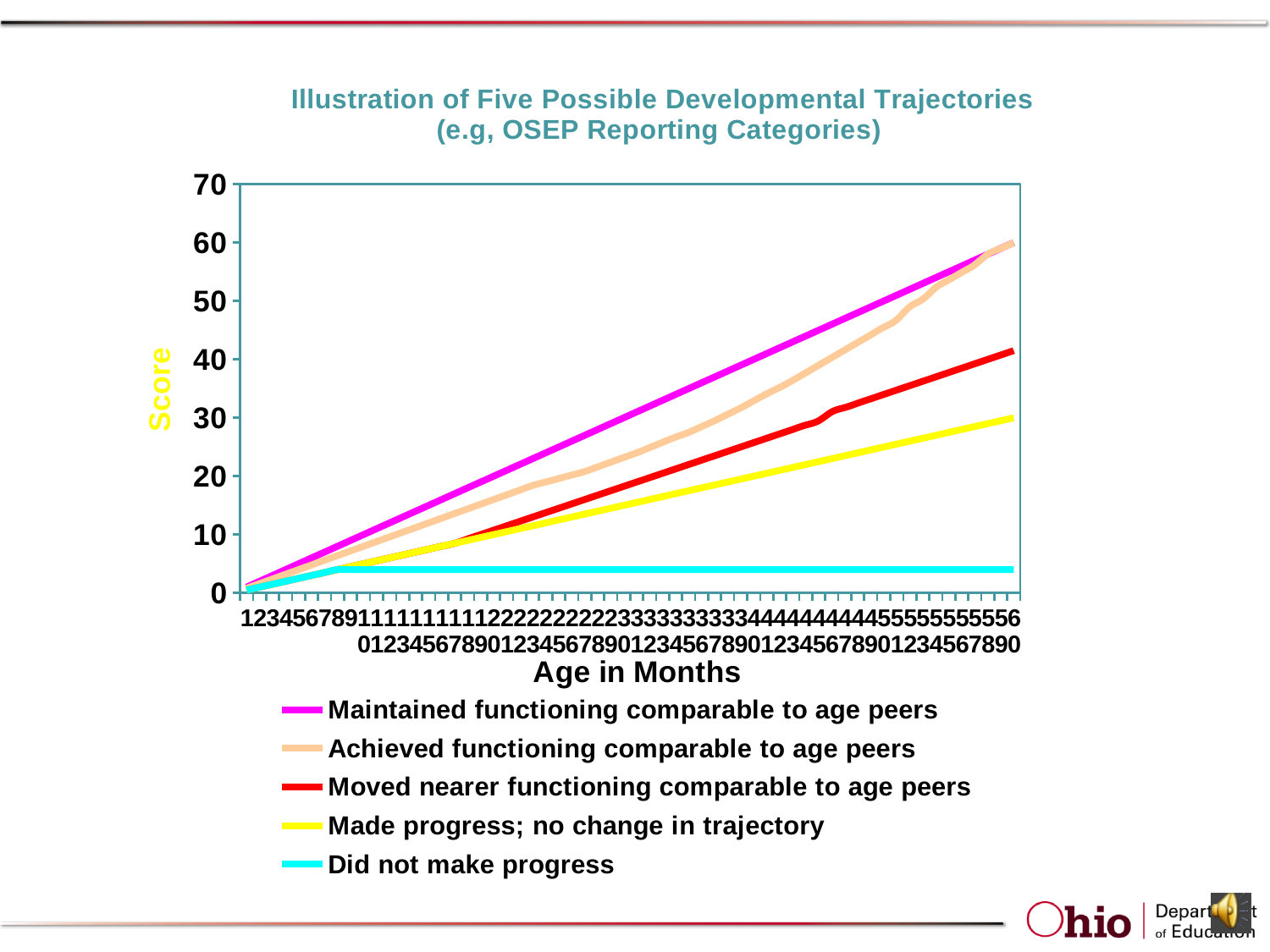
Is the value of the 'Made progress; no change in trajectory' series at the right end of the x axis greater or less than 40? less At the right end of the x axis, which is larger: the 'Moved nearer functioning comparable to age peers' series or the 'Made progress; no change in trajectory' series? Moved nearer functioning comparable to age peers Is the value of the 'Did not make progress' series at the right end of the x axis greater or less than 10? less Is the value of the 'Moved nearer functioning comparable to age peers' series at the right end of the x axis greater or less than 30? greater What kind of chart is shown on the slide? line chart What is the title of the chart? Illustration of Five Possible Developmental Trajectories (e.g, OSEP Reporting Categories) Does the 'Maintained functioning comparable to age peers' series rise or fall as age in months increases? rise How many series does the legend list? 5 Which series has the lowest value at the right end of the x axis? Did not make progress What is the label of the y axis? Score